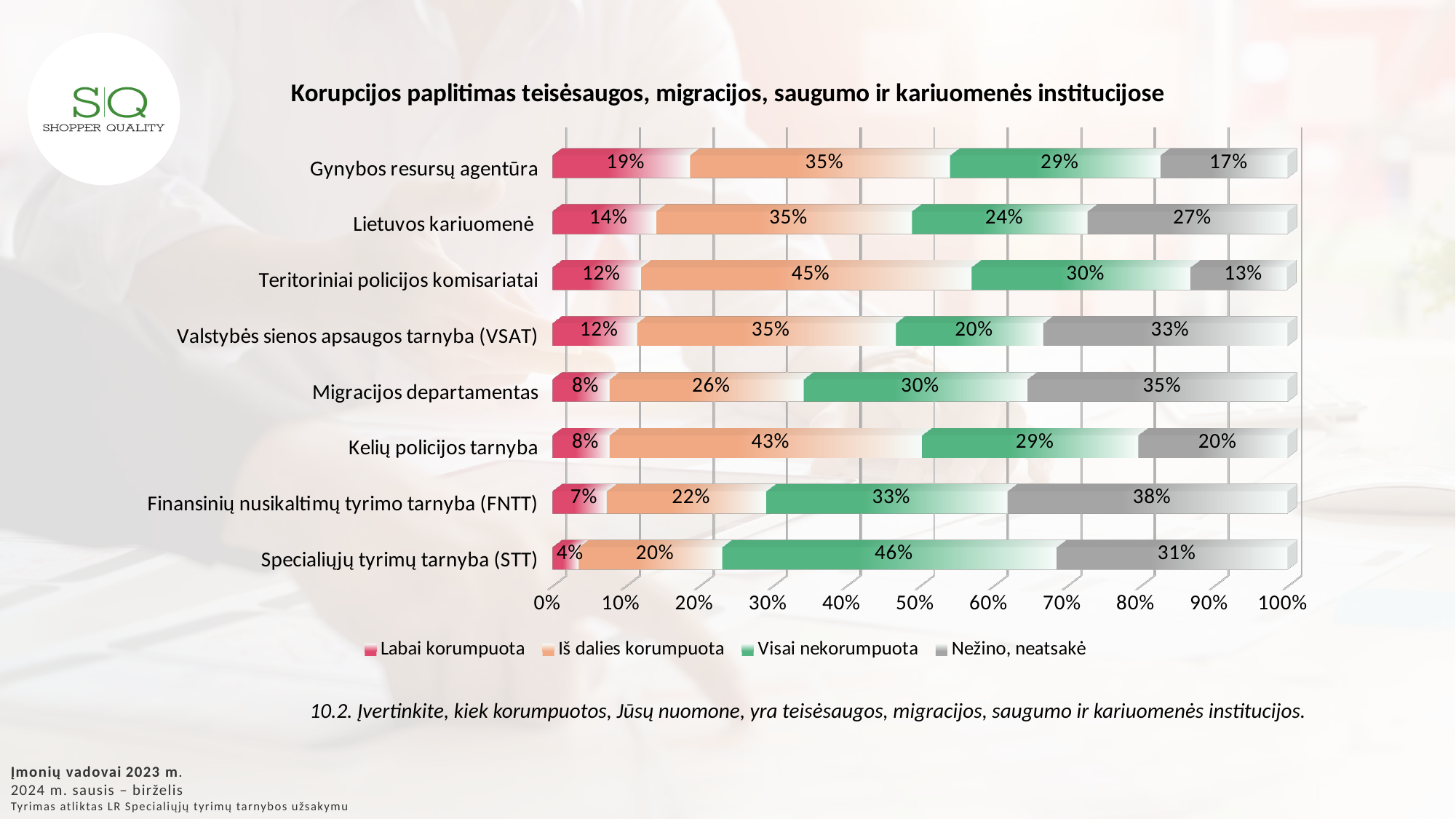
What percentage of respondents rated Specialiųjų tyrimų tarnyba (STT) as "Visai nekorumpuota"? 46% What is the "Nežino, neatsakė" value for Finansinių nusikaltimų tyrimo tarnyba (FNTT)? 38% What kind of chart is shown on the slide? Stacked bar chart What is the "Iš dalies korumpuota" value for Teritoriniai policijos komisariatai? 45% Which institution has the highest "Labai korumpuota" value? Gynybos resursų agentūra Which has a larger "Visai nekorumpuota" value: Migracijos departamentas or Valstybės sienos apsaugos tarnyba (VSAT)? Migracijos departamentas How many series does the legend list? 4 What is the combined "Labai korumpuota" and "Iš dalies korumpuota" share for Kelių policijos tarnyba? 51% What is the difference between the "Nežino, neatsakė" values for Lietuvos kariuomenė and Gynybos resursų agentūra? 10% Which institution has the lowest "Labai korumpuota" value? Specialiųjų tyrimų tarnyba (STT) How many institutions are shown in the chart? 8 Which series is shown in green in the chart? Visai nekorumpuota